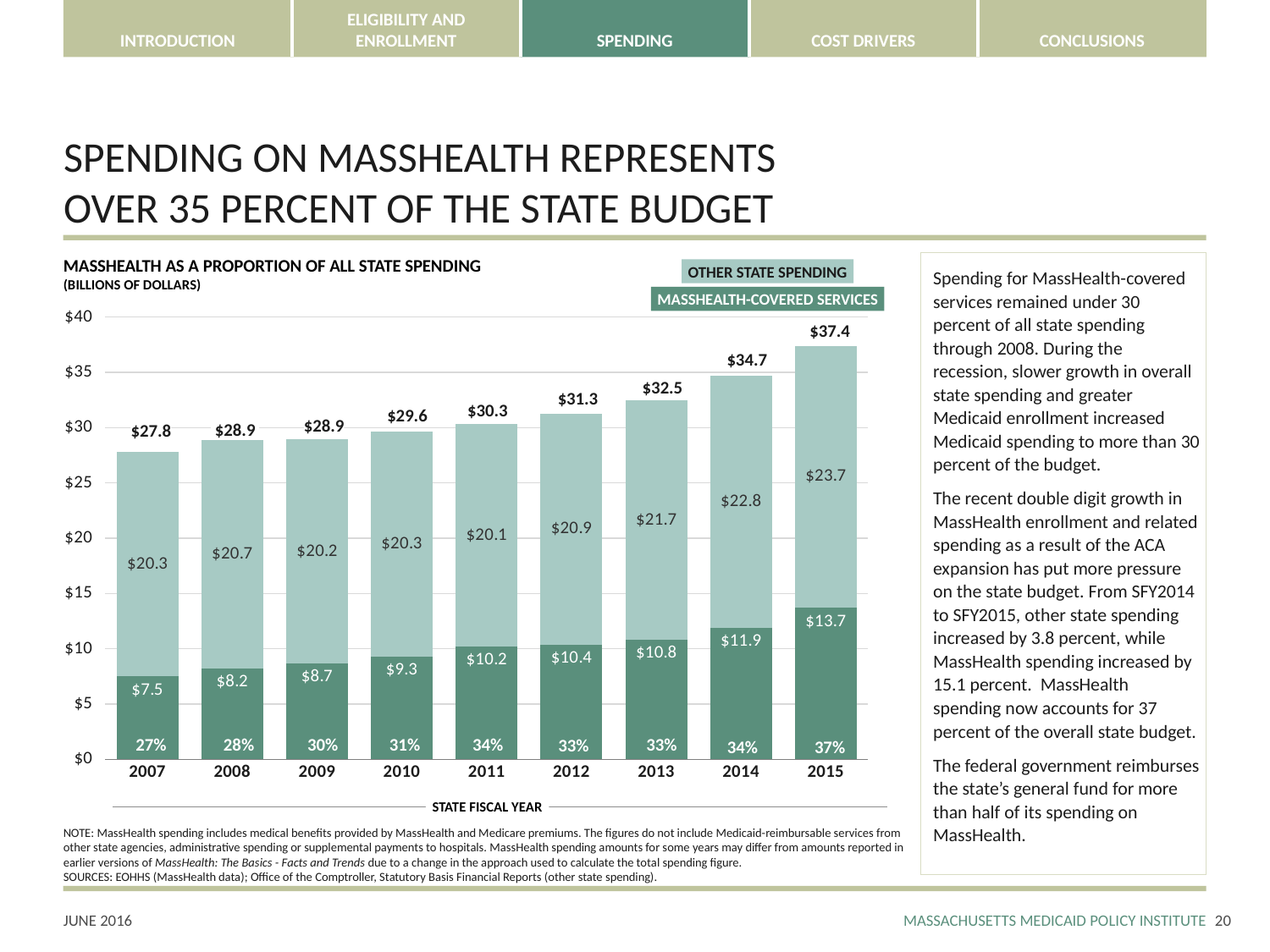
How many series does the legend list? 2 What is the difference between total state spending in 2015 and 2014? $2.7 What percentage of state spending did MassHealth represent in 2011? 34% What kind of chart is shown on the slide? Stacked bar chart Which state fiscal year had the highest total state spending? 2015 How many state fiscal years are shown on the chart? 9 What was the total state spending shown for 2013? $32.5 What was MassHealth-covered services spending in 2015? $13.7 Does MassHealth-covered services spending rise or fall from 2007 to 2015? Rise Which is larger, MassHealth-covered services spending in 2012 or in 2009? 2012 Which state fiscal year had the lowest MassHealth-covered services spending? 2007 What was other state spending in 2010? $20.3